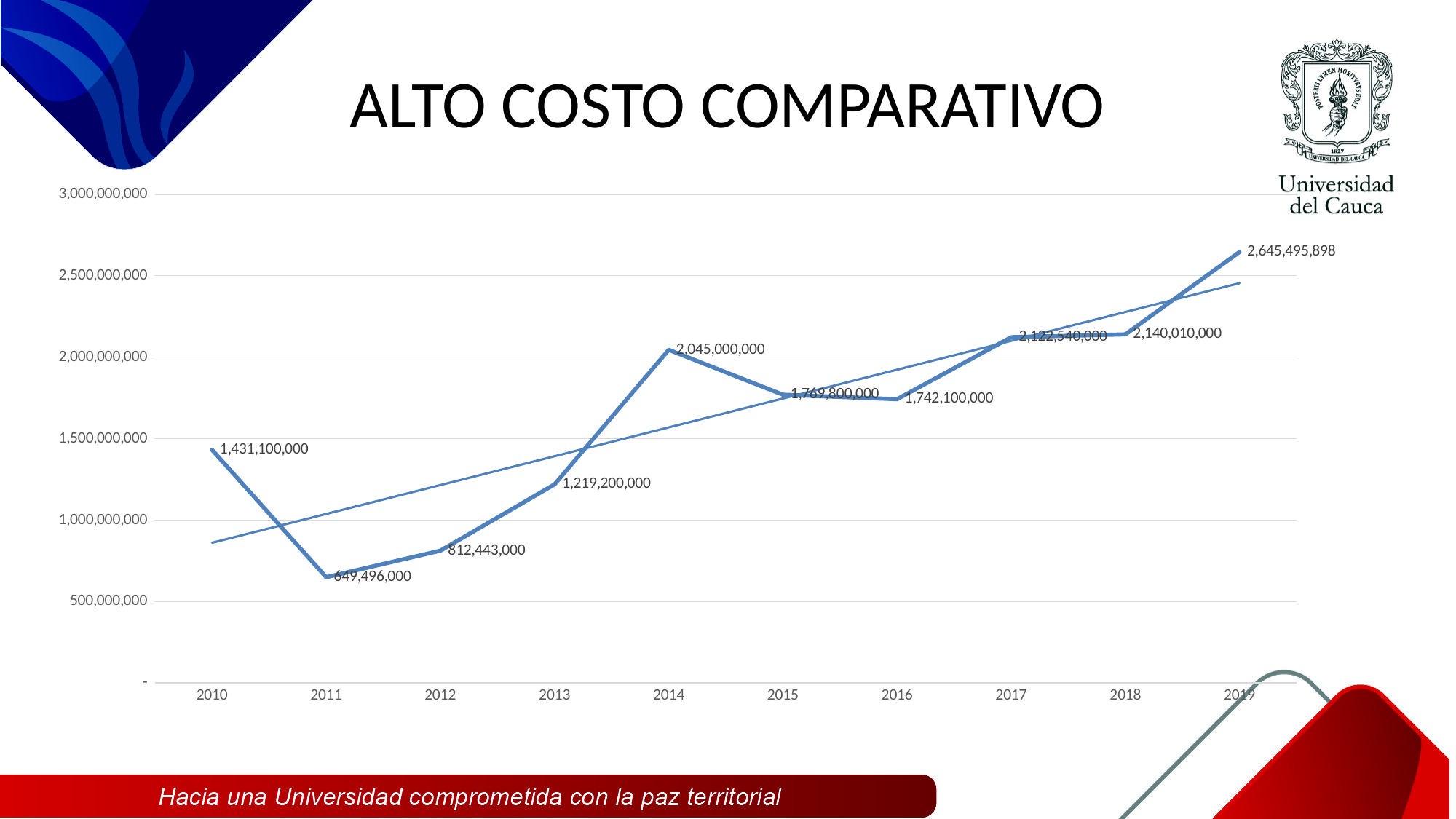
Which year has the lowest value? 2011 What kind of chart is shown on the slide? line chart What is the value for 2010? 1,431,100,000 What is the value for 2019? 2,645,495,898 What is the value for 2011? 649,496,000 Which is larger, the value for 2012 or the value for 2013? 2013 What is the difference between the values for 2019 and 2018? 505,485,898 What is the value for 2014? 2,045,000,000 Is the value for 2015 greater or less than 1,500,000,000? greater How many years are plotted on the x axis? 10 Which year has the highest value? 2019 What is the difference between the values for 2014 and 2013? 825,800,000